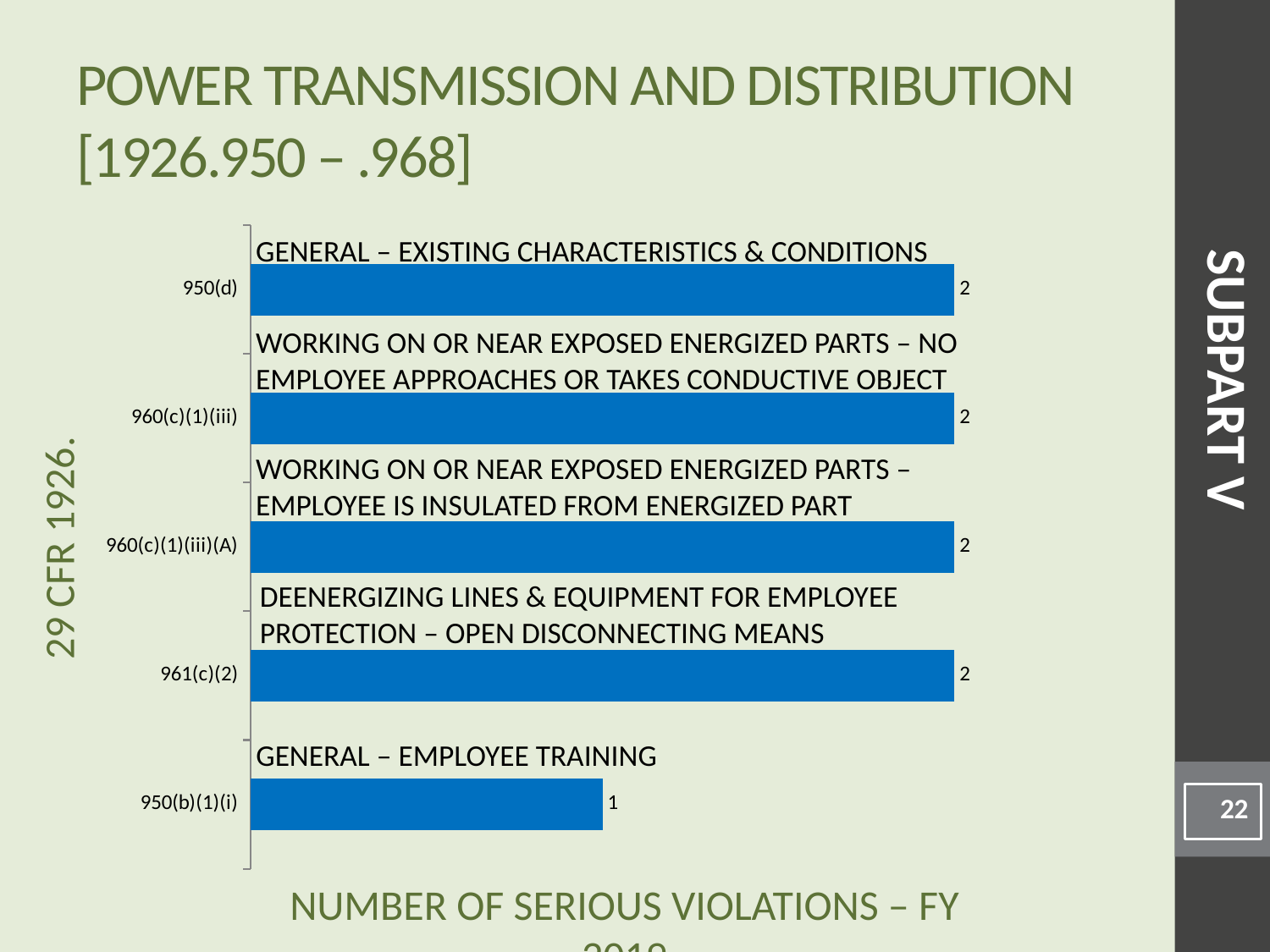
What is the number of serious violations for 950(b)(1)(i)? 1 Which category has the lowest number of serious violations? 950(b)(1)(i) What is the number of serious violations for 950(d)? 2 Which has a larger value, 960(c)(1)(iii) or 950(b)(1)(i)? 960(c)(1)(iii) What is the label on the vertical axis of the chart? 29 CFR 1926. What is the difference between the values for 950(d) and 950(b)(1)(i)? 1 How many categories are plotted in the chart? 5 What is the number of serious violations for 961(c)(2)? 2 Which category is labelled 'GENERAL – EMPLOYEE TRAINING'? 950(b)(1)(i) What kind of chart is shown on the slide? bar chart What is the number of serious violations for 960(c)(1)(iii)(A)? 2